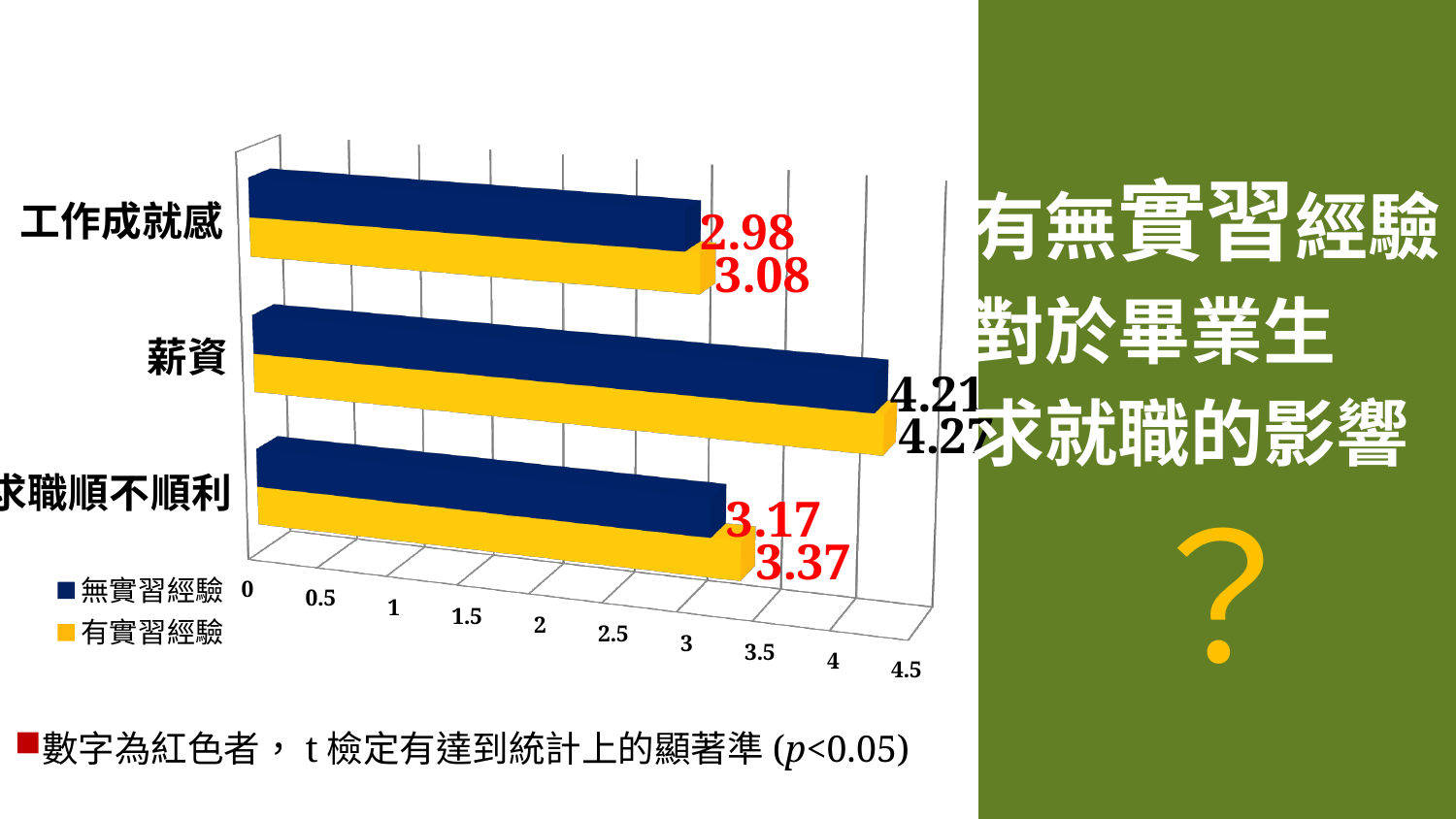
What is the value for 有實習經驗 in the 薪資 category? 4.27 What is the value for 無實習經驗 in the 薪資 category? 4.21 What is the value for 有實習經驗 in the 求職順不順利 category? 3.37 What is the difference between 有實習經驗 and 無實習經驗 in the 求職順不順利 category? 0.20 Which category has the lowest value for 無實習經驗? 工作成就感 How many categories are shown on the chart? 3 In the 工作成就感 category, which series has the larger value, 無實習經驗 or 有實習經驗? 有實習經驗 Which colour represents the 有實習經驗 series? Yellow Which category has the highest value for 有實習經驗? 薪資 What is the value for 無實習經驗 in the 工作成就感 category? 2.98 What kind of chart is shown on the slide? Bar chart How many series does the legend list? 2